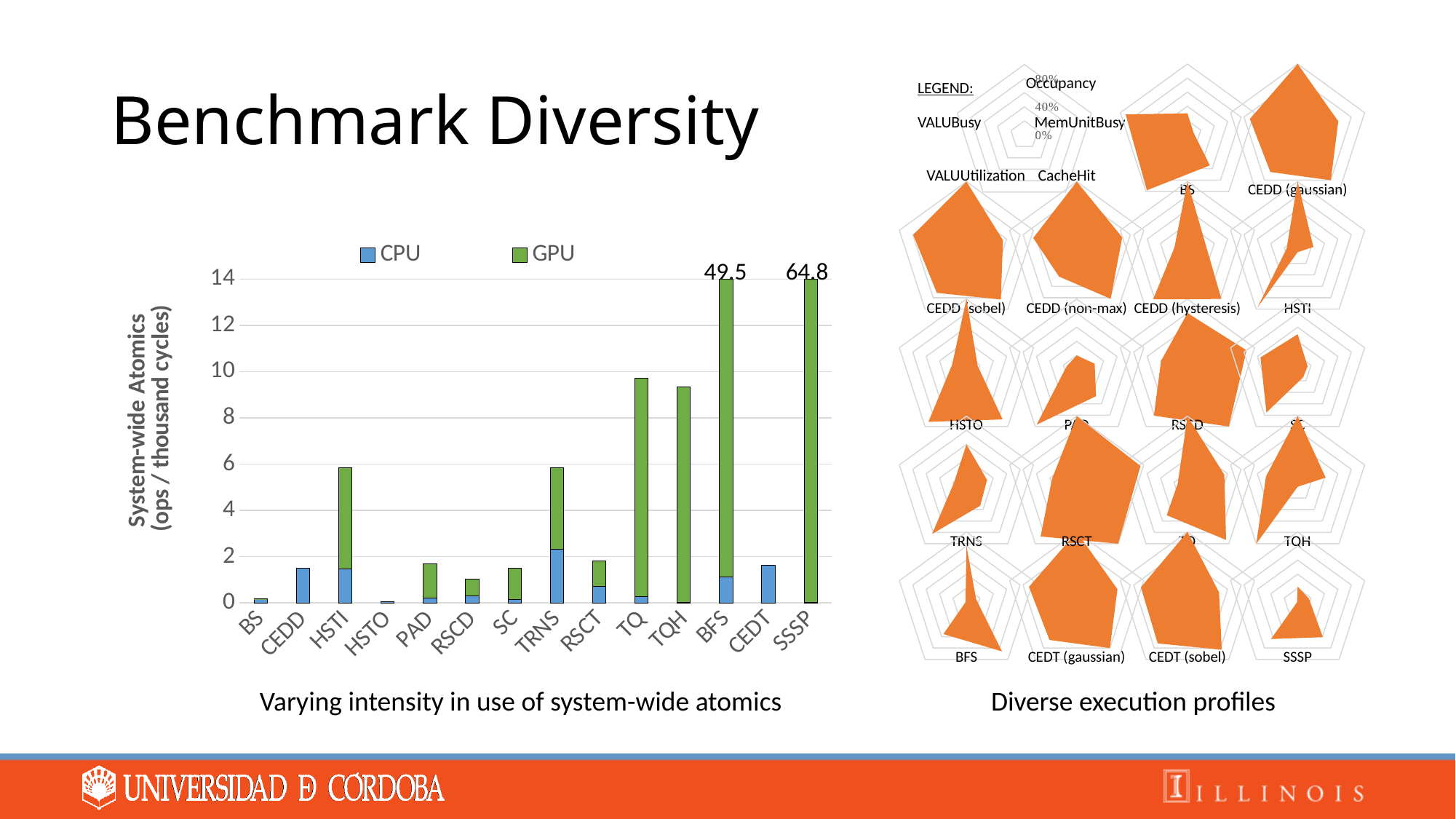
In the left bar chart, is the total value for TQ greater or less than 8? greater In the left bar chart, how many benchmark categories are shown on the x axis? 14 In the left bar chart, what is the difference between the labelled values for SSSP and BFS? 15.3 In the left bar chart, what is the y-axis title? System-wide Atomics (ops / thousand cycles) In the left bar chart, which benchmark has the highest total system-wide atomics? SSSP In the left bar chart, what value is printed above the BFS bar? 49.5 In the left bar chart, which has the larger total bar, PAD or RSCD? PAD In the left bar chart, what value is printed above the SSSP bar? 64.8 In the left bar chart, how many series does the legend list? 2 In the left bar chart, is the total value for HSTO greater or less than 2? less In the radar charts on the right, how many metrics does the legend list as axes? 5 What kind of chart is the left chart showing system-wide atomics? Stacked bar chart